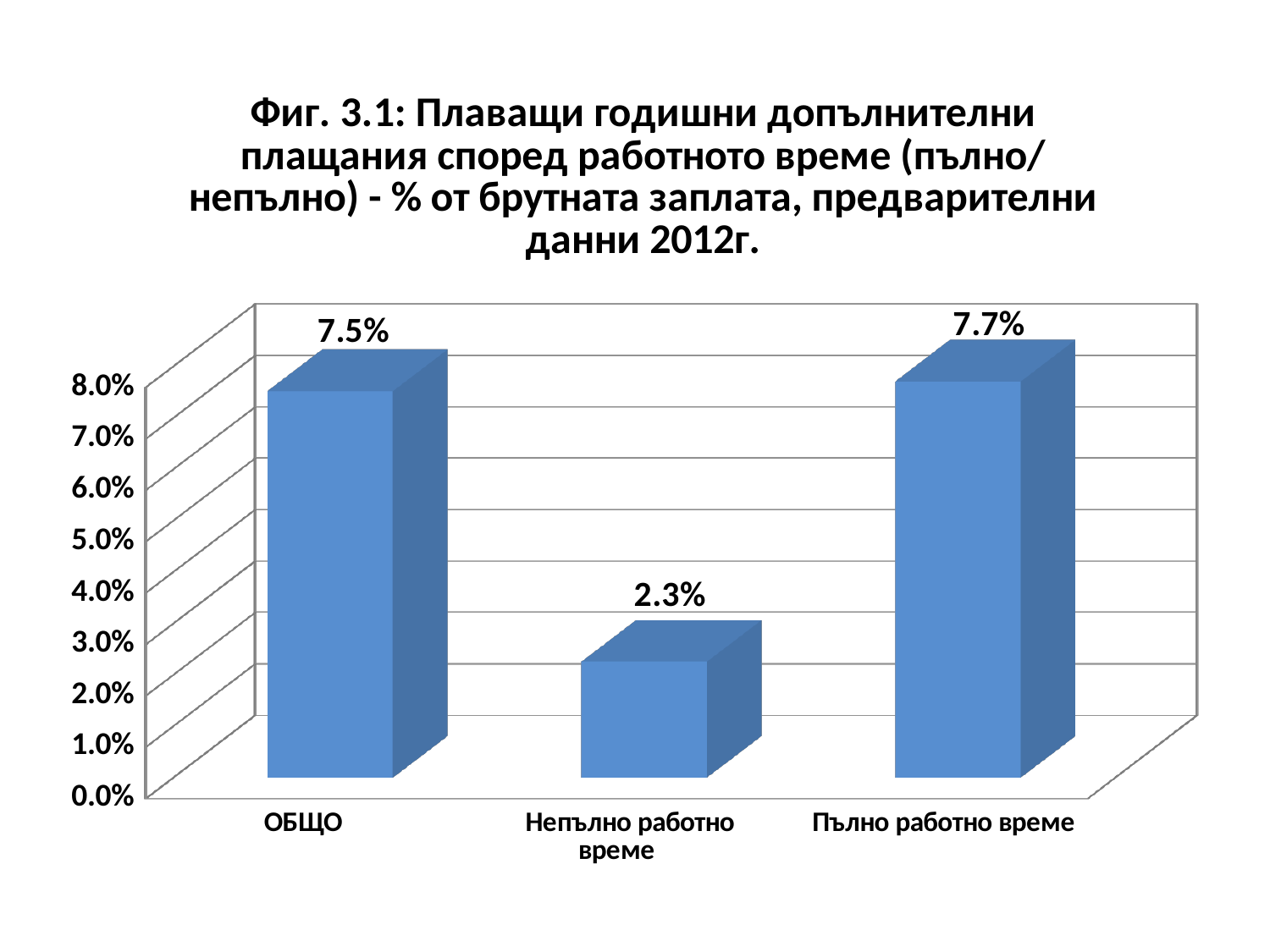
What is the highest value shown on the vertical axis? 8.0% Which is larger, the value for ОБЩО or the value for Непълно работно време? ОБЩО What is the difference between the values for Пълно работно време and ОБЩО? 0.2% What is the value for Пълно работно време? 7.7% Is the value for Непълно работно време greater or less than 3.0%? less What is the value for Непълно работно време? 2.3% What is the value for ОБЩО? 7.5% Which category has the highest value? Пълно работно време Which category has the lowest value? Непълно работно време How many categories are shown on the chart? 3 What kind of chart is shown on the slide? bar chart What is the difference between the values for Пълно работно време and Непълно работно време? 5.4%